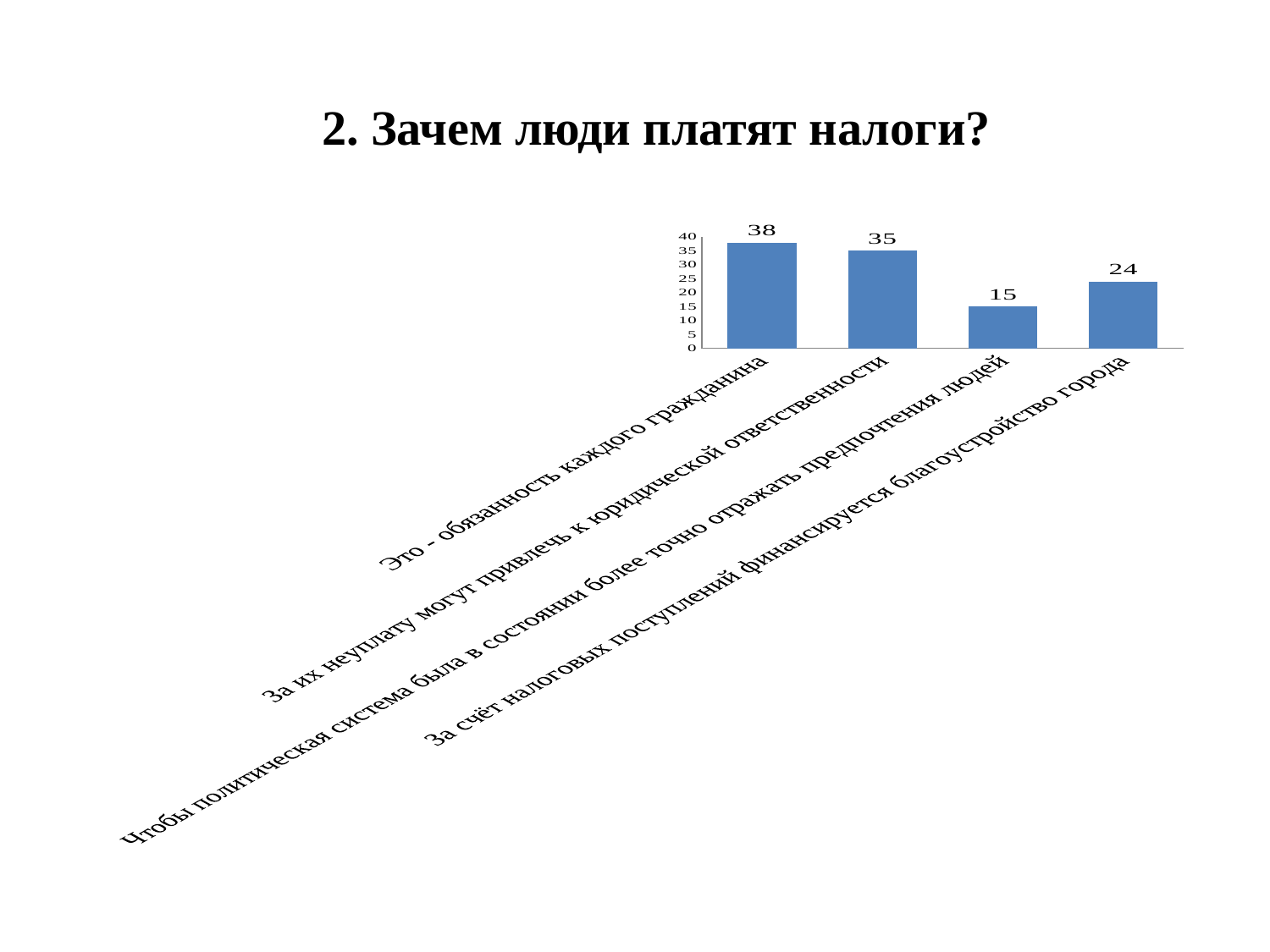
What is the difference between the values for "Это - обязанность каждого гражданина" and "За счёт налоговых поступлений финансируется благоустройство города"? 14 How many categories are shown in the chart? 4 Which category has the highest value? Это - обязанность каждого гражданина Which is larger: the value for "За их неуплату могут привлечь к юридической ответственности" or for "За счёт налоговых поступлений финансируется благоустройство города"? За их неуплату могут привлечь к юридической ответственности What is the value for "Чтобы политическая система была в состоянии более точно отражать предпочтения людей"? 15 What is the value for "За их неуплату могут привлечь к юридической ответственности"? 35 What is the value for "За счёт налоговых поступлений финансируется благоустройство города"? 24 Which category has the lowest value? Чтобы политическая система была в состоянии более точно отражать предпочтения людей What is the title of the slide? 2. Зачем люди платят налоги? What kind of chart is shown on the slide? bar chart Is the value for "Чтобы политическая система была в состоянии более точно отражать предпочтения людей" greater or less than 20? less What is the value for "Это - обязанность каждого гражданина"? 38